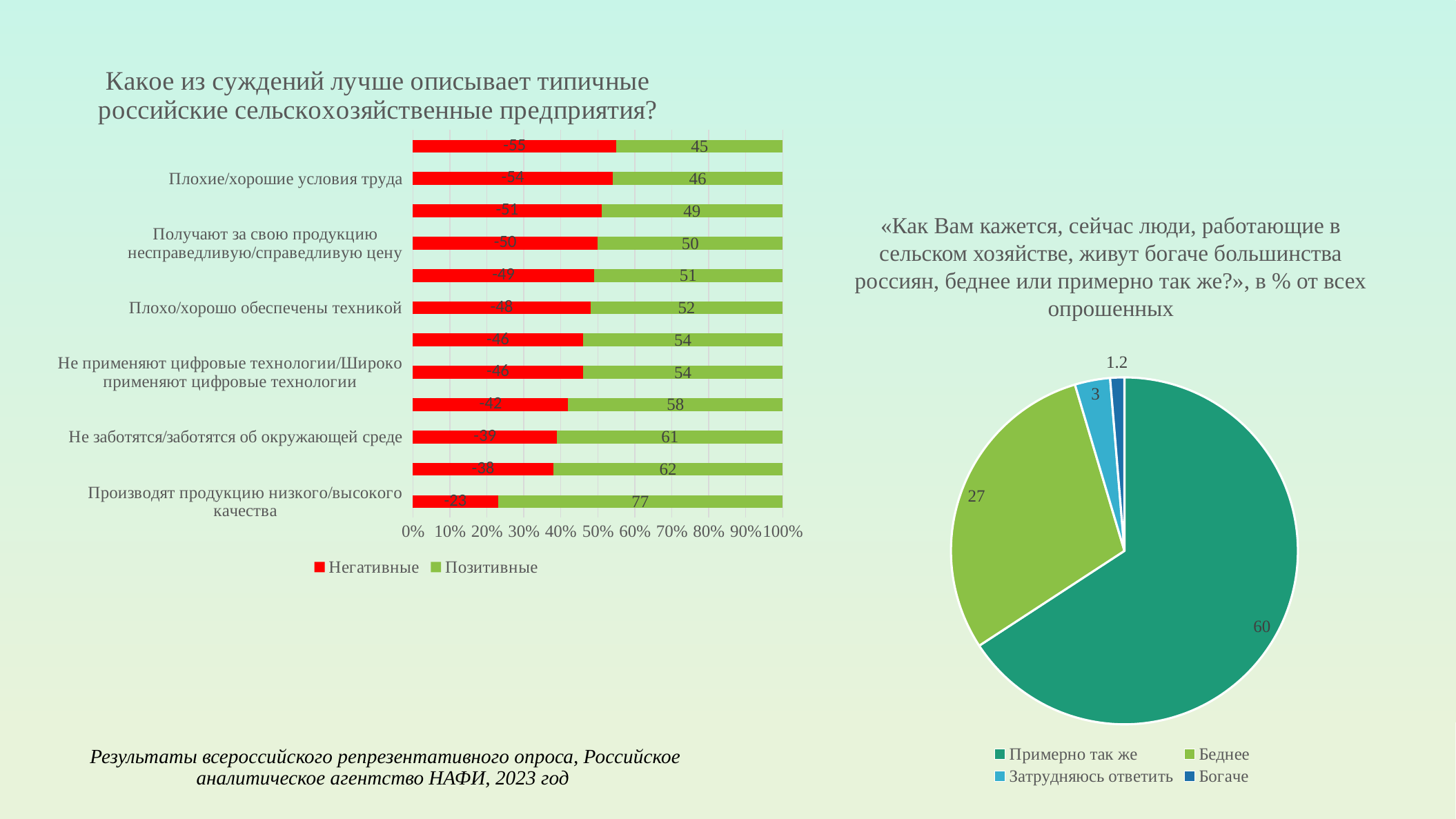
In the bar chart on the left, what is the largest value in the «Позитивные» series? 77 What kind of chart is the chart on the left of the slide? Bar chart In the pie chart on the right, what is the value for «Богаче»? 1.2 In the bar chart on the left, how many series does the legend list? 2 In the pie chart on the right, how many slices are there? 4 In the pie chart on the right, what is the value for «Примерно так же»? 60 What kind of chart is the chart on the right of the slide? Pie chart In the pie chart on the right, what is the value for «Беднее»? 27 In the pie chart on the right, which category has the largest slice? Примерно так же In the pie chart on the right, what is the difference between the values for «Примерно так же» and «Беднее»? 33 In the pie chart on the right, which category has the smallest slice? Богаче In the bar chart on the left, how many bars are plotted? 12